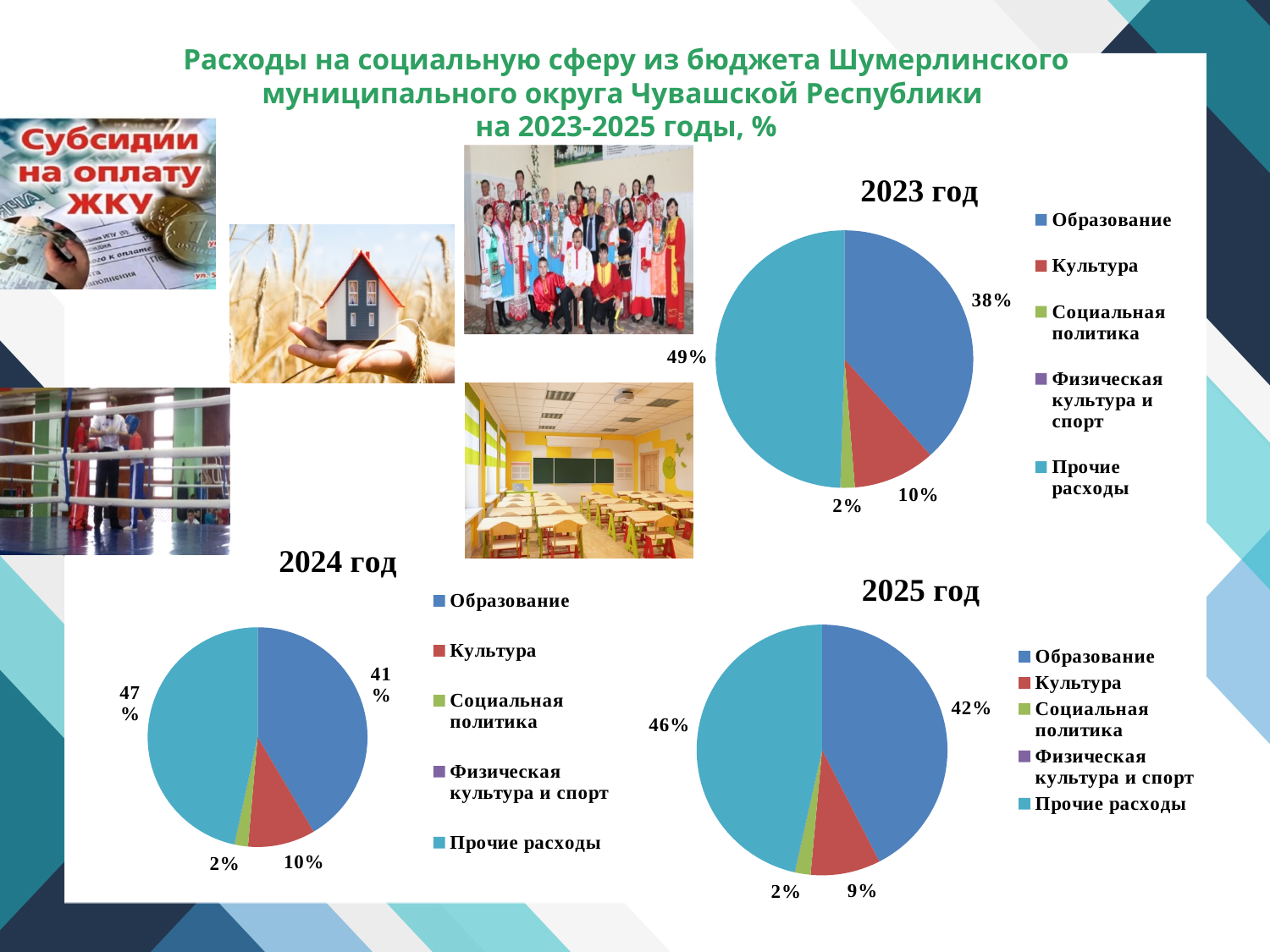
On the "2025 год" chart, what share is labelled for Культура? 9% On the "2023 год" chart, what share is labelled for Образование? 38% On the "2024 год" chart, which category has the largest slice? Прочие расходы On the "2024 год" chart, what is the difference between the shares for Образование and Культура? 31% On the "2023 год" chart, what share is labelled for Прочие расходы? 49% On the "2025 год" chart, what is the difference between the shares for Прочие расходы and Образование? 4% On the "2025 год" chart, what share is labelled for Образование? 42% How many pie charts are shown on the slide? 3 How many entries does the legend of the "2023 год" chart list? 5 What type of chart is the "2025 год" chart? Pie chart On the "2024 год" chart, what share is labelled for Культура? 10% On the "2023 год" chart, which is larger: the slice for Образование or the slice for Прочие расходы? Прочие расходы